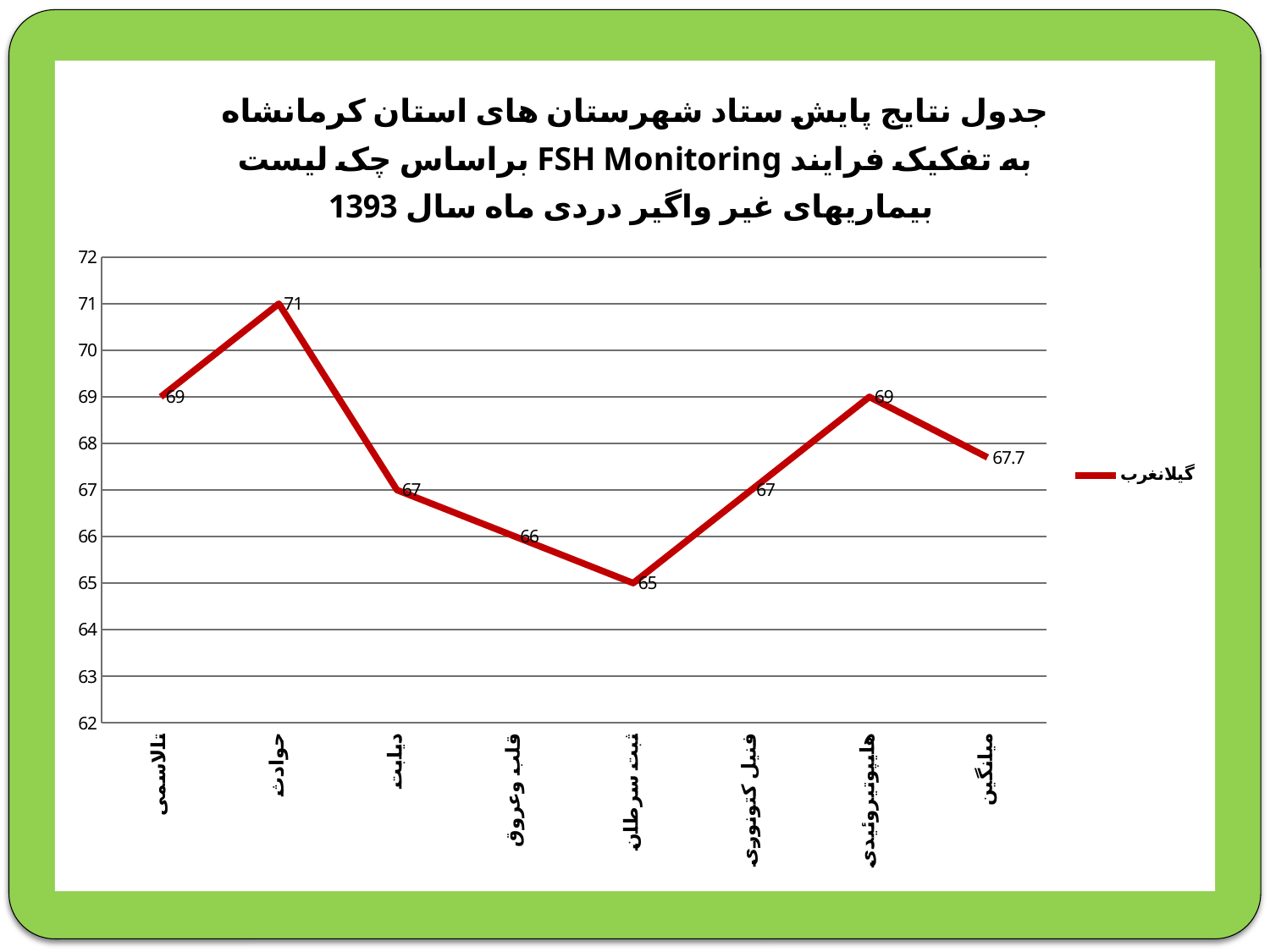
Which category has the highest value? حوادث How many categories are plotted on the x axis? 8 How many series does the legend list? 1 What is the value for ثبت سرطان? 65 What is the value for میانگین? 67.7 What is the name of the series shown in the legend? گیلانغرب Which is larger, the value for تالاسمی or the value for دیابت? تالاسمی What is the value for حوادث? 71 What is the difference between the values for حوادث and ثبت سرطان? 6 Which category has the lowest value? ثبت سرطان What is the value for قلب وعروق? 66 What type of chart is shown on the slide? line chart